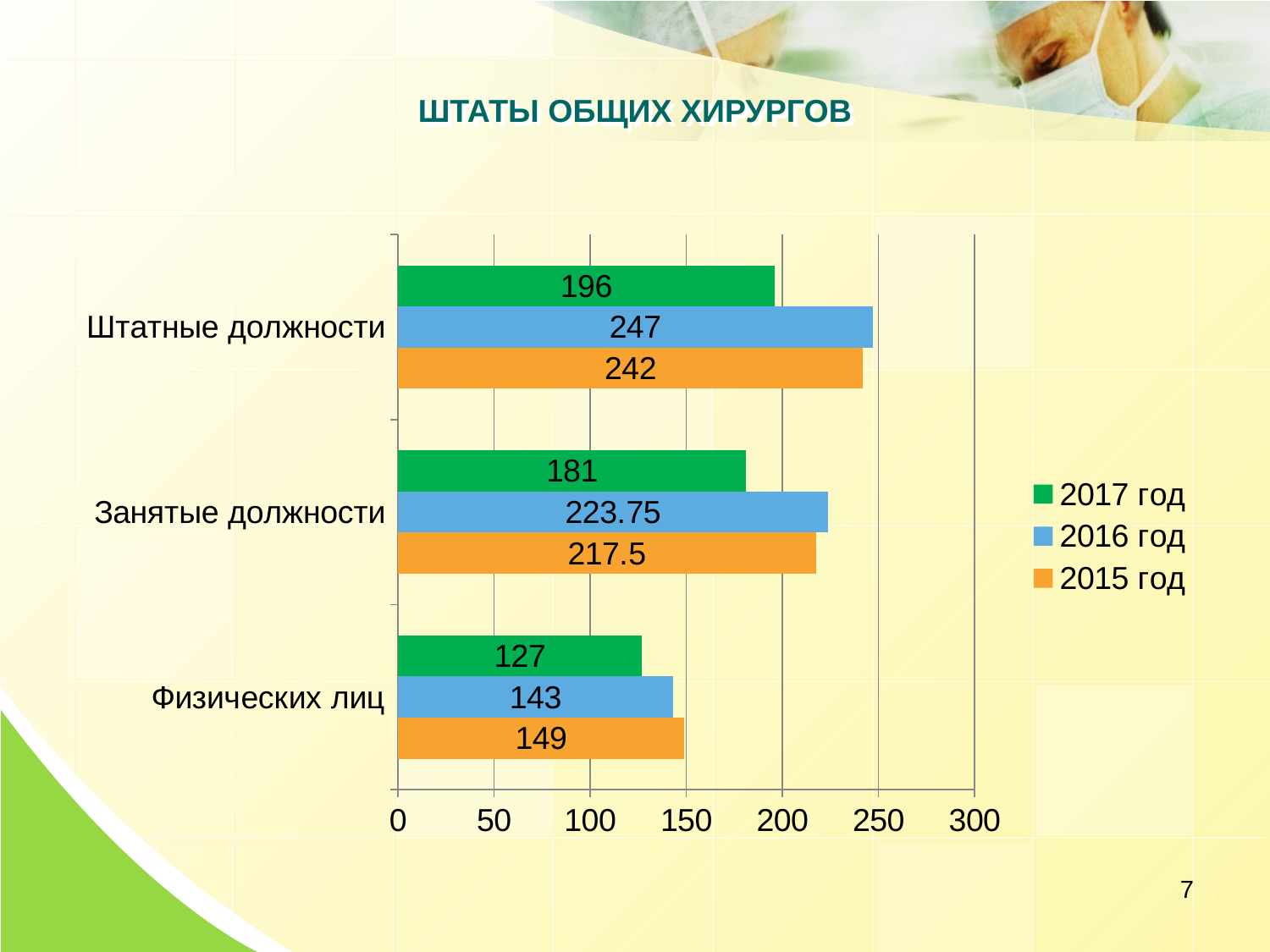
How many series does the legend list? 3 What is the value for Физических лиц in 2015 год? 149 Which category has the highest value in the 2016 год series? Штатные должности Which is larger for Физических лиц: the 2015 год value or the 2016 год value? 2015 год What is the value for Занятые должности in 2016 год? 223.75 Which category has the lowest value in the 2017 год series? Физических лиц What is the value for Штатные должности in 2017 год? 196 How many categories are shown on the chart? 3 What kind of chart is shown on the slide? Bar chart What is the difference between the 2016 год and 2017 год values for Штатные должности? 51 What is the title of the slide? ШТАТЫ ОБЩИХ ХИРУРГОВ Is the value for Занятые должности in 2015 год greater or less than 200? greater